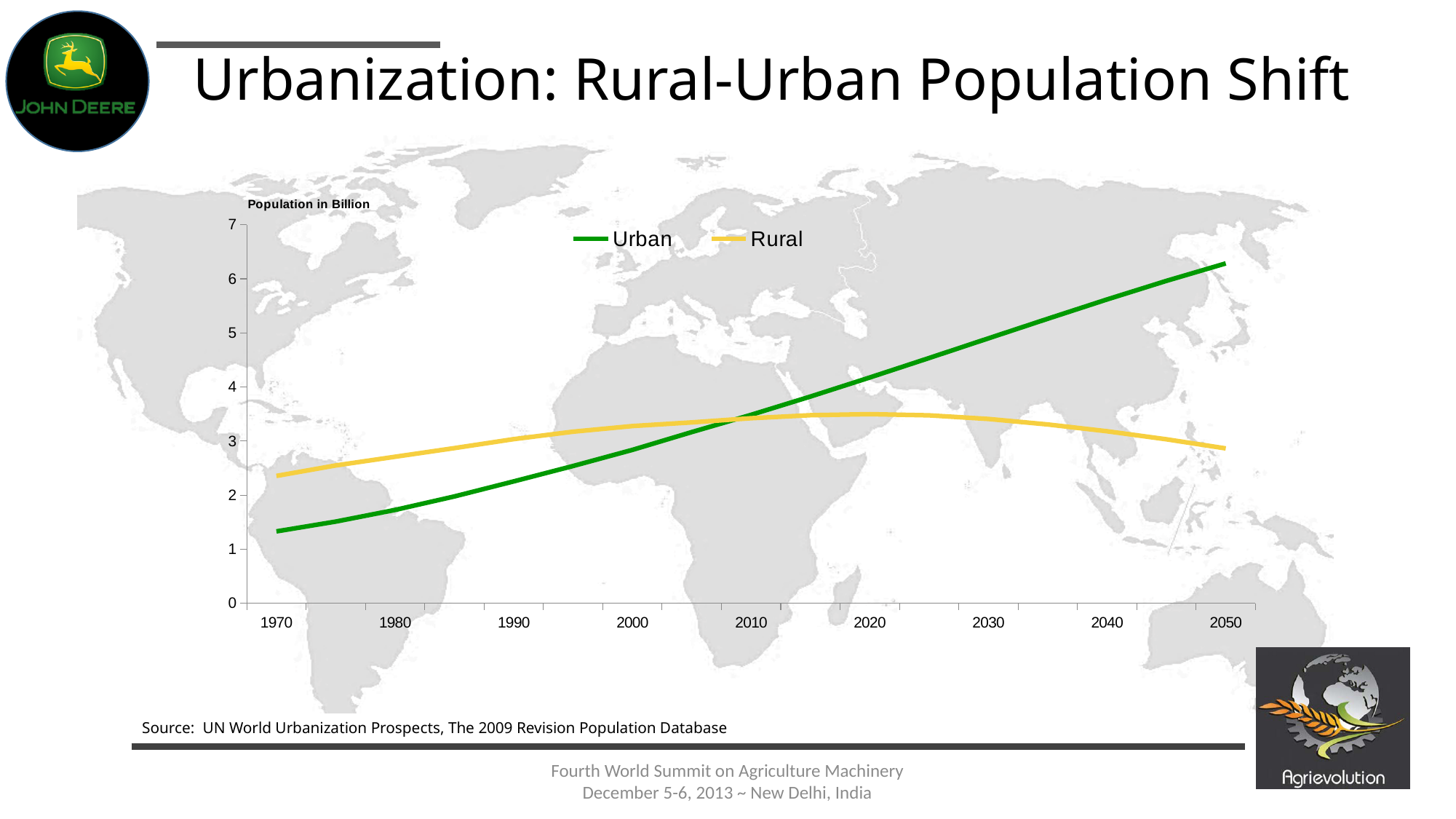
Is the Urban value in 1970 greater or less than 2 billion? less How many year labels are shown along the x axis of the chart? 9 Is the Rural value in 1970 greater or less than 2 billion? greater What are the two series named in the chart legend? Urban and Rural How many series does the chart legend list? 2 In 1970, which series has the larger population, Urban or Rural? Rural In 2050, which series has the larger population, Urban or Rural? Urban Is the Urban value in 2050 greater or less than 6 billion? greater What kind of chart is shown on the slide? line chart Does the Urban line rise or fall from 1970 to 2050? rise What is the label on the vertical axis of the chart? Population in Billion